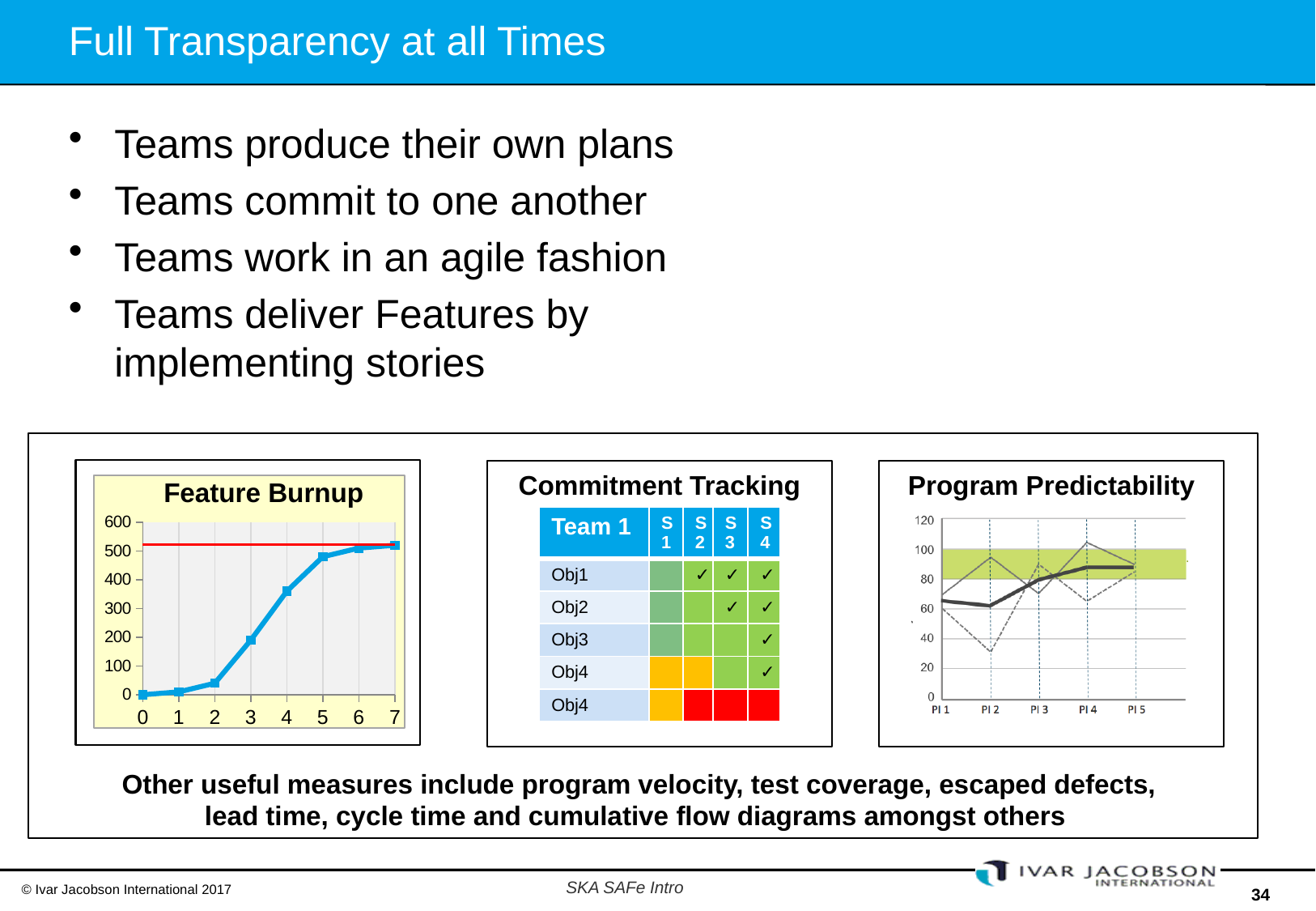
What kind of chart is the Program Predictability chart? line chart In the Program Predictability chart, is the value of the thick black line at PI 1 greater or less than 80? less How many PI categories are shown on the x axis of the Program Predictability chart? 5 How many data points are plotted on the Feature Burnup line? 8 In the Feature Burnup chart, what is the value at x = 0? 0 In the Feature Burnup chart, is the value at x = 4 greater or less than 300? greater What kind of chart is the Feature Burnup chart? line chart In the Feature Burnup chart, is the value at x = 3 greater or less than 300? less In the Feature Burnup chart, which x value has the highest plotted value? 7 In the Feature Burnup chart, do the plotted values rise or fall as the x axis goes from 0 to 7? rise In the Feature Burnup chart, what is the highest value shown on the y axis? 600